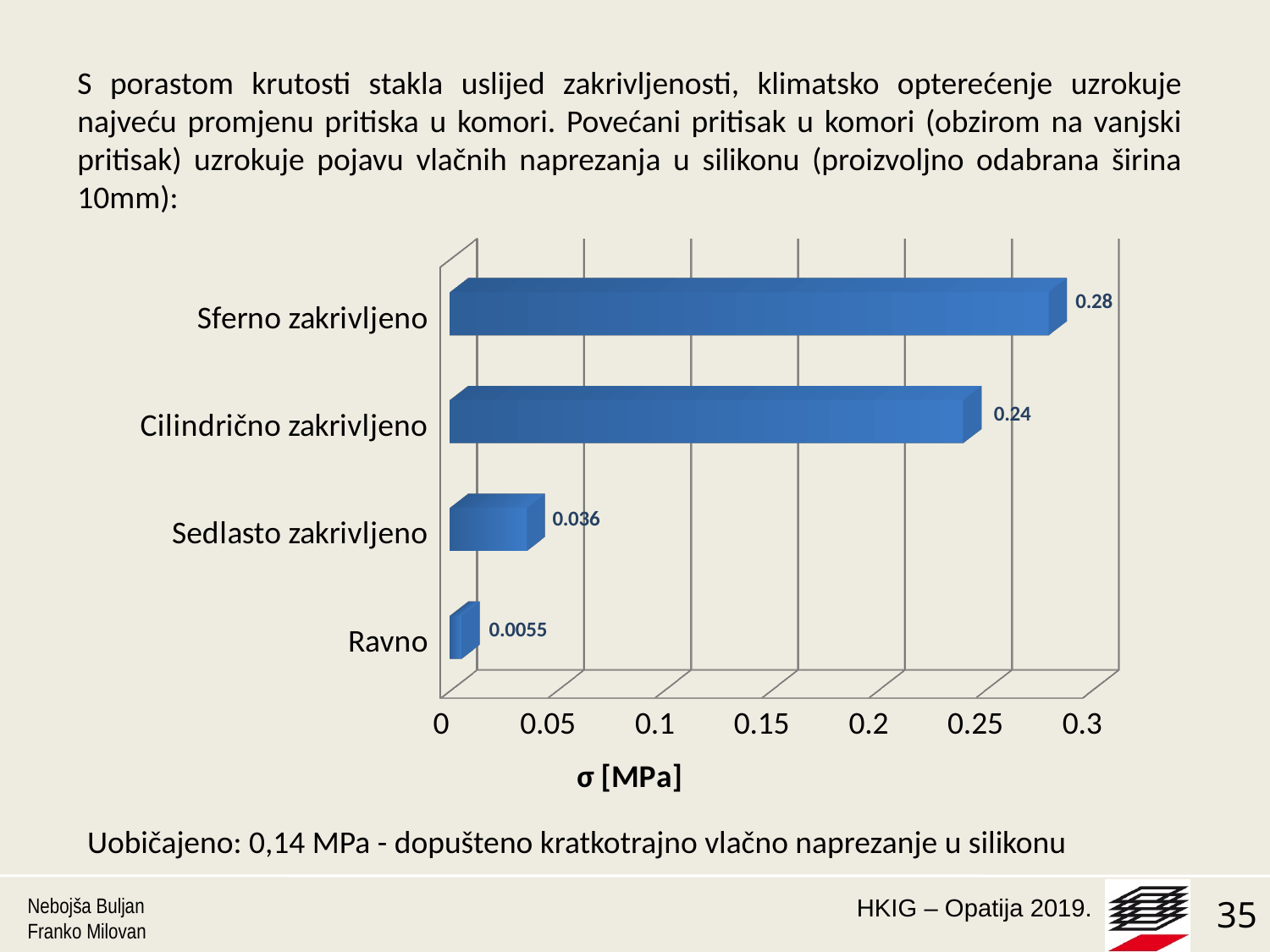
Which category has the highest value? Sferno zakrivljeno What is the value for Sferno zakrivljeno? 0.28 What is the value for Ravno? 0.0055 What is the difference between the values for Sferno zakrivljeno and Cilindrično zakrivljeno? 0.04 Which category has the lowest value? Ravno How many categories are shown in the chart? 4 What kind of chart is shown on the slide? bar chart What is the label of the horizontal axis of the chart? σ [MPa] Which is larger, the value for Sedlasto zakrivljeno or the value for Ravno? Sedlasto zakrivljeno What is the value for Cilindrično zakrivljeno? 0.24 What is the value for Sedlasto zakrivljeno? 0.036 Is the value for Cilindrično zakrivljeno greater or less than 0.2? greater